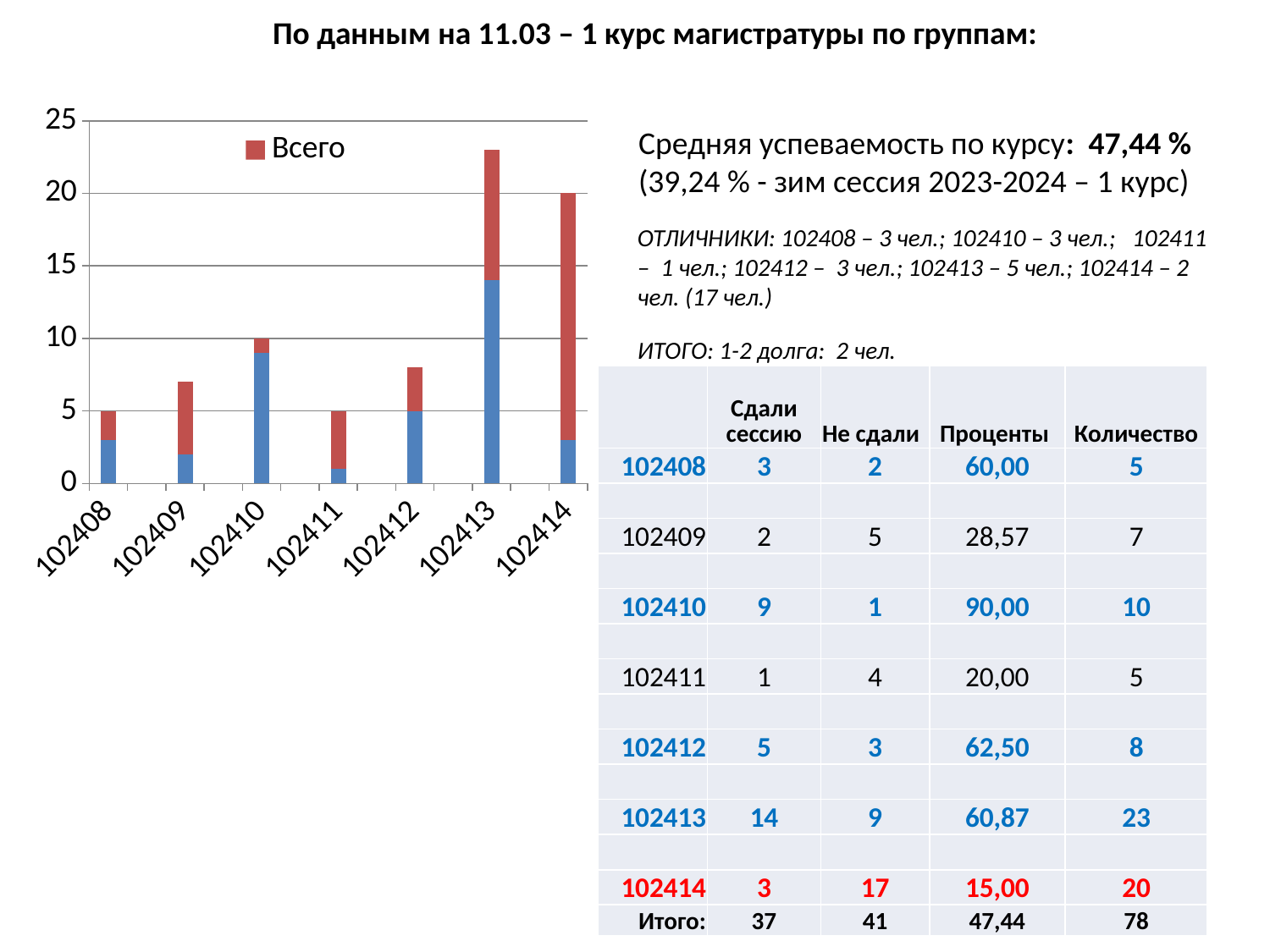
What is the difference between the total bar heights of groups 102414 and 102410? 10 What kind of chart is shown on the slide? bar chart Which group has a taller bar, 102413 or 102414? 102413 Which group has the tallest bar in the chart? 102413 What is the total height of the bar for group 102414? 20 How many series does the chart legend list? 1 What is the name of the series shown in the chart legend? Всего What is the total height of the bar for group 102410? 10 Is the total bar for group 102409 greater or less than 10? less How many groups (categories) are shown on the x axis of the chart? 7 What colour is the 'Всего' series in the chart? red Is the total bar for group 102413 greater or less than 20? greater